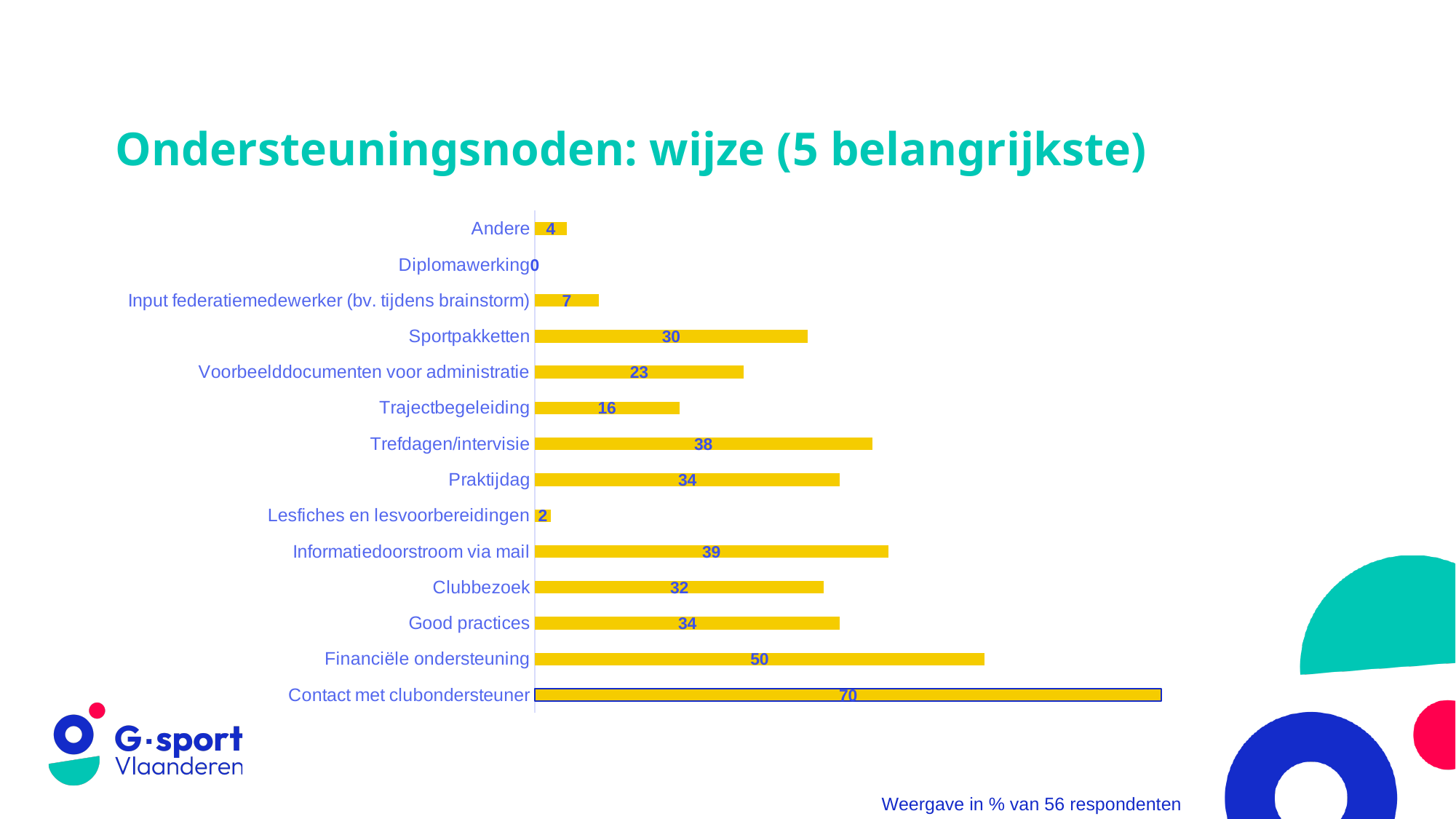
What kind of chart is shown on the slide? Bar chart Which category has the lowest value? Diplomawerking Which is larger, the value for Trefdagen/intervisie or the value for Sportpakketten? Trefdagen/intervisie Which category has the highest value? Contact met clubondersteuner What is the value for Trajectbegeleiding? 16 What is the difference between the values for Contact met clubondersteuner and Financiële ondersteuning? 20 What is the difference between the values for Informatiedoorstroom via mail and Clubbezoek? 7 What is the value for Diplomawerking? 0 What is the value for Financiële ondersteuning? 50 How many categories are shown in the chart? 14 What is the value for Contact met clubondersteuner? 70 What is the title of the slide? Ondersteuningsnoden: wijze (5 belangrijkste)